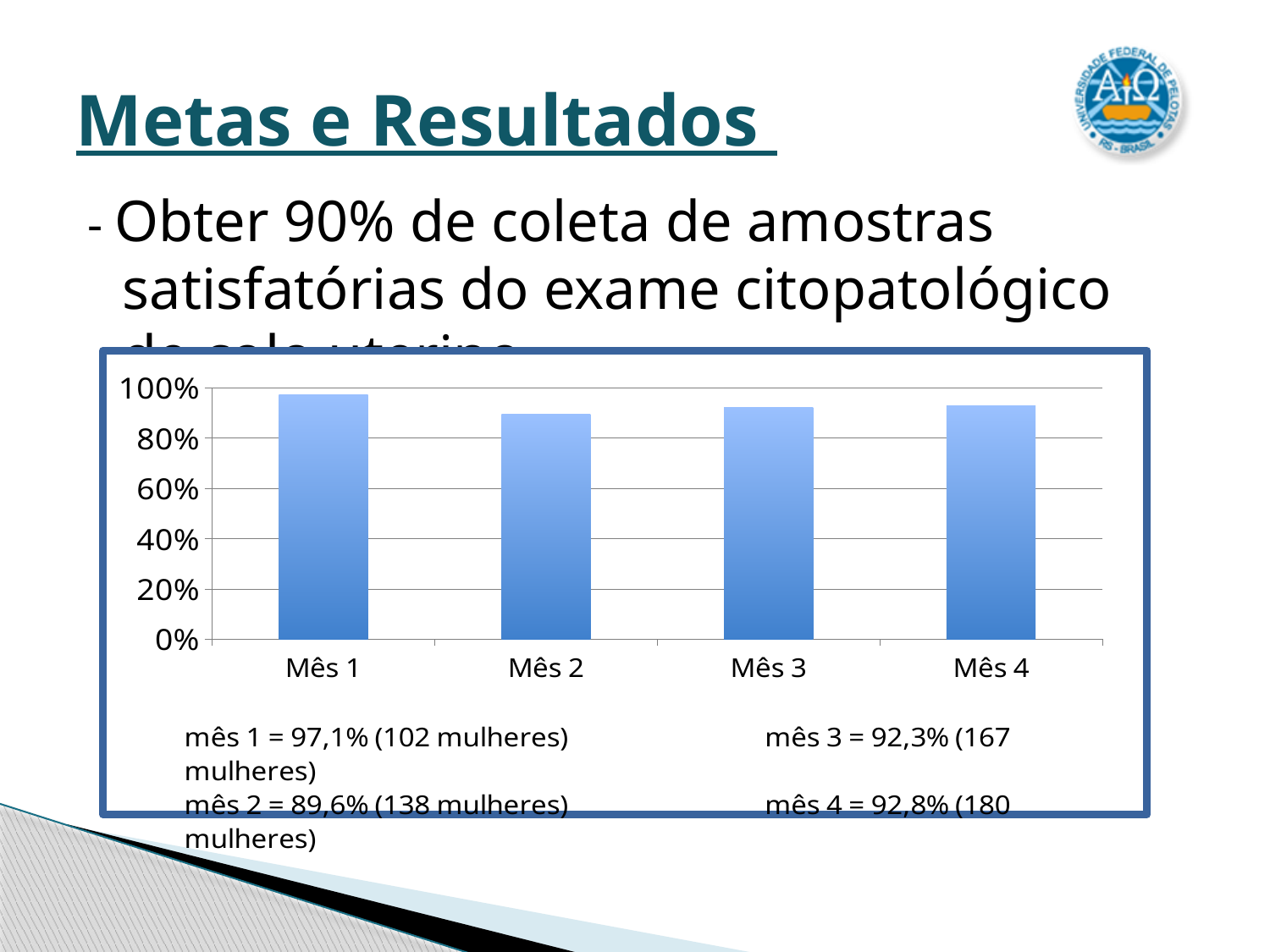
What is the value for Mês 4? 92,8% How many women does the text below the chart give for mês 4? 180 mulheres How many months (categories) are plotted in the chart? 4 What is the value for Mês 2? 89,6% What is the value for Mês 1? 97,1% Is the value for Mês 2 greater or less than 80%? greater What is the value for Mês 3? 92,3% Which month has the lowest value in the chart? Mês 2 Which is larger, the value for Mês 1 or the value for Mês 3? Mês 1 Which month has the highest value in the chart? Mês 1 What is the difference between the values for Mês 1 and Mês 2? 7,5% What kind of chart is shown on the slide? bar chart